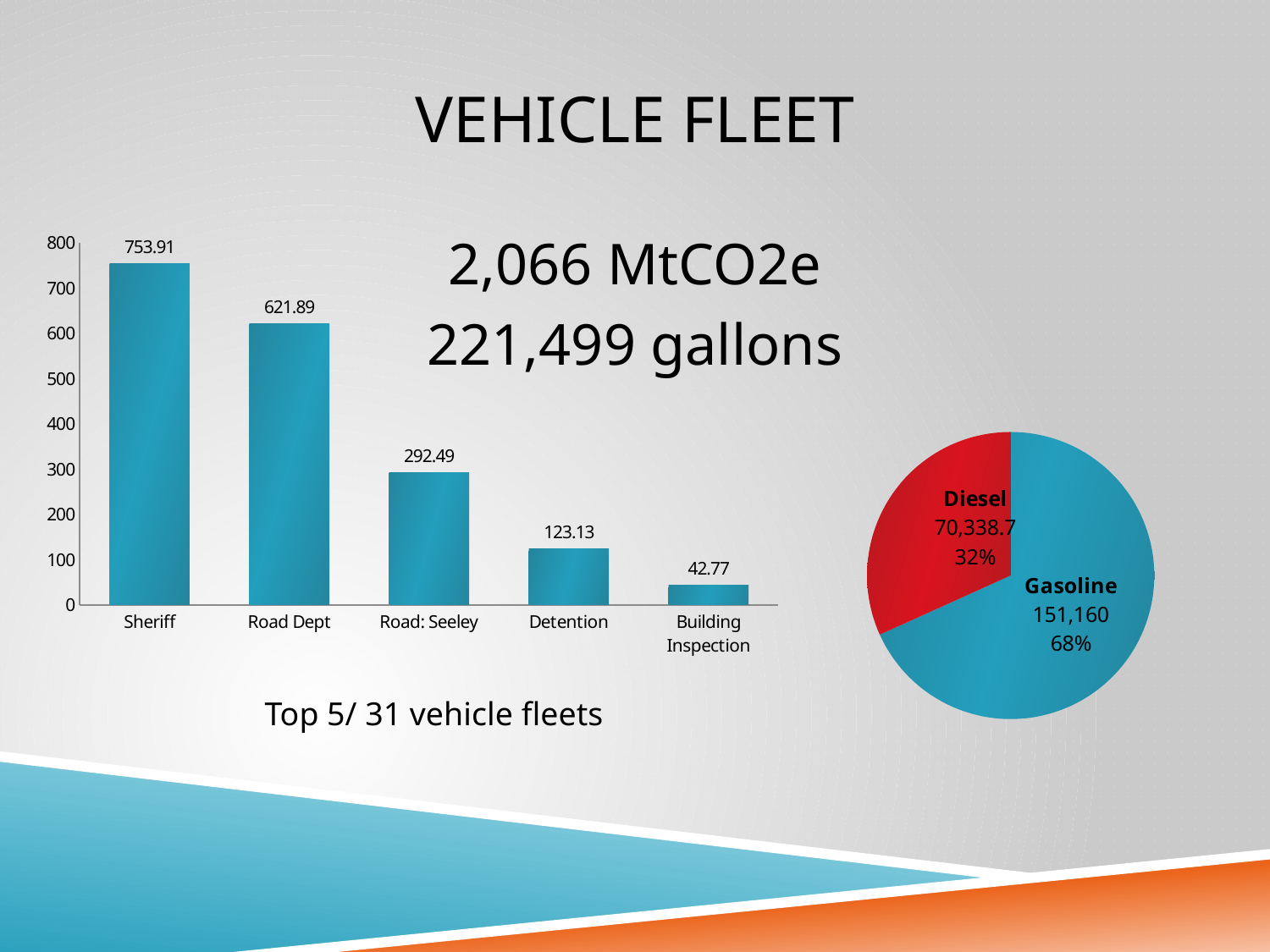
In the pie chart on the right, what share does Gasoline have? 68% In the bar chart on the left, which category has the highest value? Sheriff In the bar chart on the left, what is the value for Sheriff? 753.91 How many categories are shown in the bar chart on the left? 5 In the bar chart on the left, do the values rise or fall from left to right? Fall In the bar chart on the left, what is the value for Building Inspection? 42.77 In the bar chart on the left, what is the difference between the values for Sheriff and Road Dept? 132.02 In the bar chart on the left, which is larger, the value for Road: Seeley or the value for Detention? Road: Seeley In the bar chart on the left, which category has the lowest value? Building Inspection In the bar chart on the left, what is the value for Road Dept? 621.89 In the pie chart on the right, what is the value for Diesel? 70,338.7 What kind of chart is the chart on the left of the slide? Bar chart